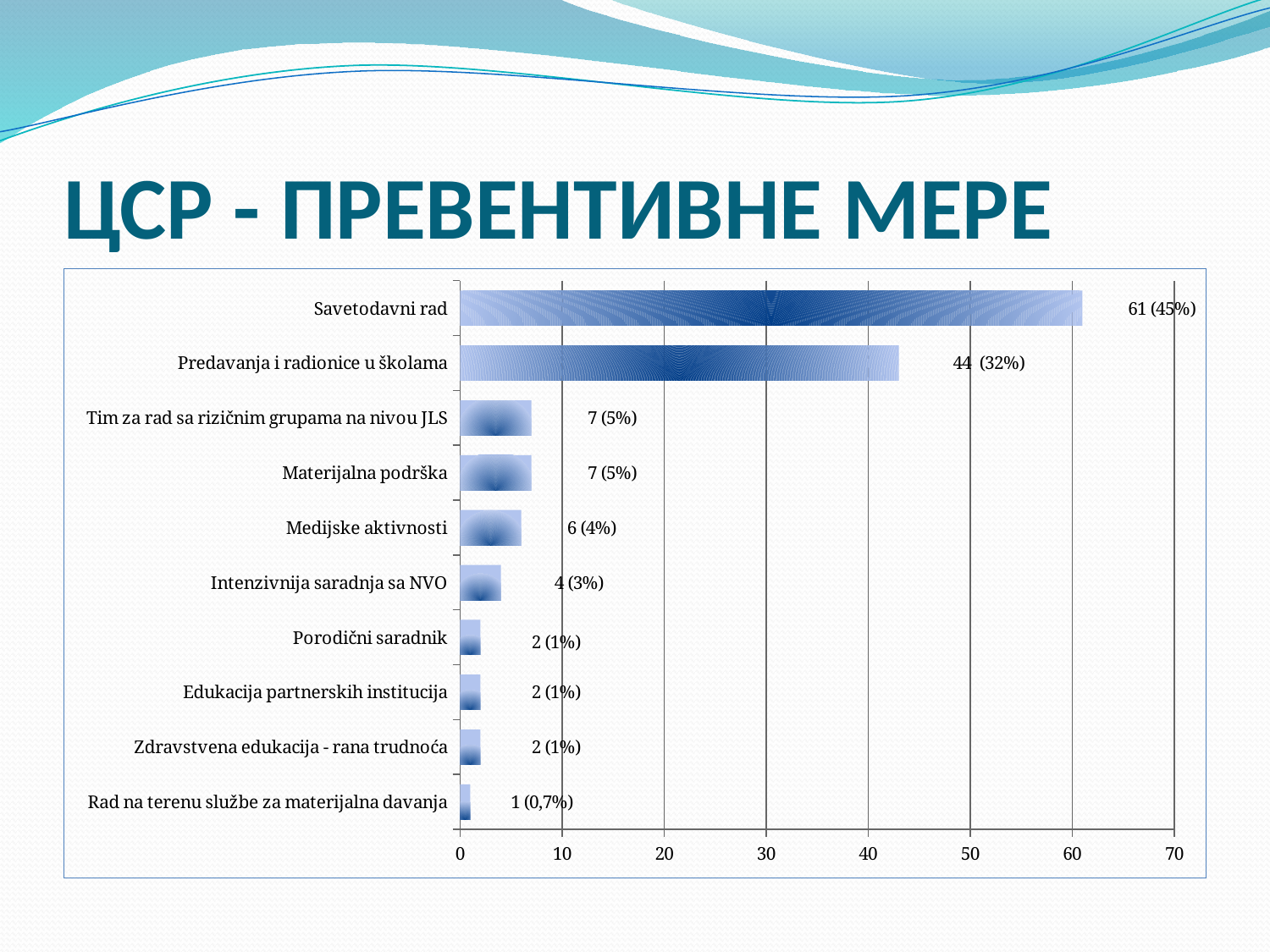
What is the difference between the counts for Savetodavni rad and Predavanja i radionice u školama? 17 Which is larger, the value for Medijske aktivnosti or the value for Intenzivnija saradnja sa NVO? Medijske aktivnosti What is the title of the slide? ЦСР - ПРЕВЕНТИВНЕ МЕРЕ What is the value shown for Rad na terenu službe za materijalna davanja? 1 (0,7%) What kind of chart is shown on the slide? bar chart Is the value for Savetodavni rad greater or less than 50? greater Which category has the lowest value? Rad na terenu službe za materijalna davanja Which category has the highest value? Savetodavni rad How many categories are shown in the chart? 10 What is the value shown for Medijske aktivnosti? 6 (4%) What is the value shown for Savetodavni rad? 61 (45%) What is the value shown for Predavanja i radionice u školama? 44 (32%)